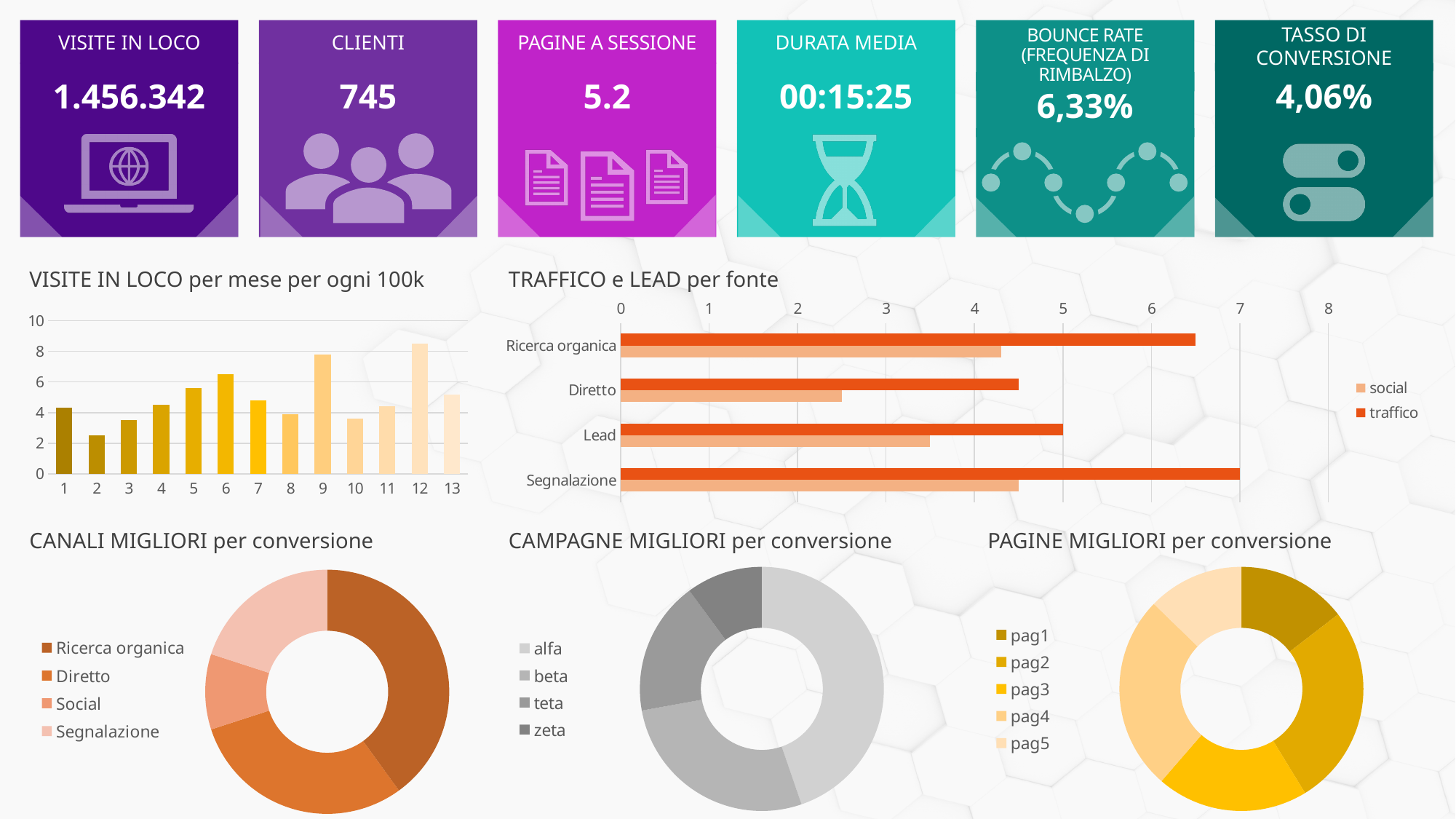
How many entries does the legend of the 'PAGINE MIGLIORI per conversione' chart list? 5 How many series does the legend of the 'TRAFFICO e LEAD per fonte' chart list? 2 How many months are plotted in the 'VISITE IN LOCO per mese per ogni 100k' chart? 13 In the 'CANALI MIGLIORI per conversione' chart, which channel has the largest slice? Ricerca organica In the 'VISITE IN LOCO per mese per ogni 100k' chart, which month has the highest value? 12 In the 'TRAFFICO e LEAD per fonte' chart, which source has the lowest 'social' value? Diretto In the 'VISITE IN LOCO per mese per ogni 100k' chart, is the value for month 2 greater or less than 4? less In the 'VISITE IN LOCO per mese per ogni 100k' chart, which month has the lowest value? 2 In the 'TRAFFICO e LEAD per fonte' chart, which source has the highest 'traffico' value? Segnalazione What kind of chart is the 'VISITE IN LOCO per mese per ogni 100k' chart? bar chart In the 'VISITE IN LOCO per mese per ogni 100k' chart, is the value for month 9 greater or less than 6? greater How many sources (categories) are shown in the 'TRAFFICO e LEAD per fonte' chart? 4